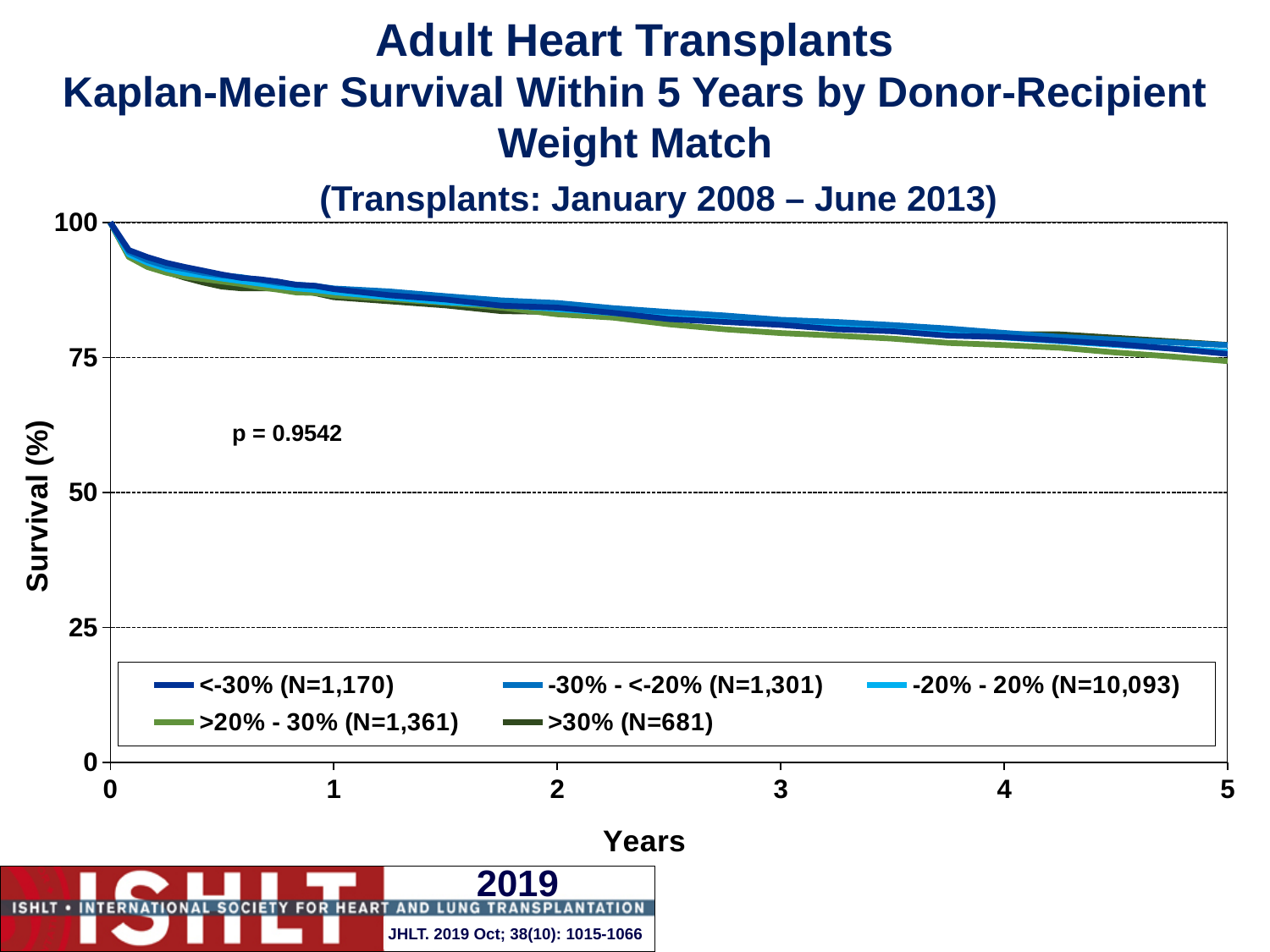
What is the N for the -20% - 20% group shown in the legend? N=10,093 Is the survival value for the >20% - 30% group at 4 years greater or less than 50? greater Is the survival value for the <-30% group at 2 years greater or less than 50? greater Is the survival value for the -20% - 20% group at 1 year greater or less than 75? greater What is the survival value for all groups at 0 years? 100 What is the maximum value shown on the x axis (Years)? 5 What kind of chart is shown on the slide? Line chart How many series does the legend list? 5 Do the survival curves rise or fall as the years increase along the x axis? Fall What is the p-value printed on the chart? p = 0.9542